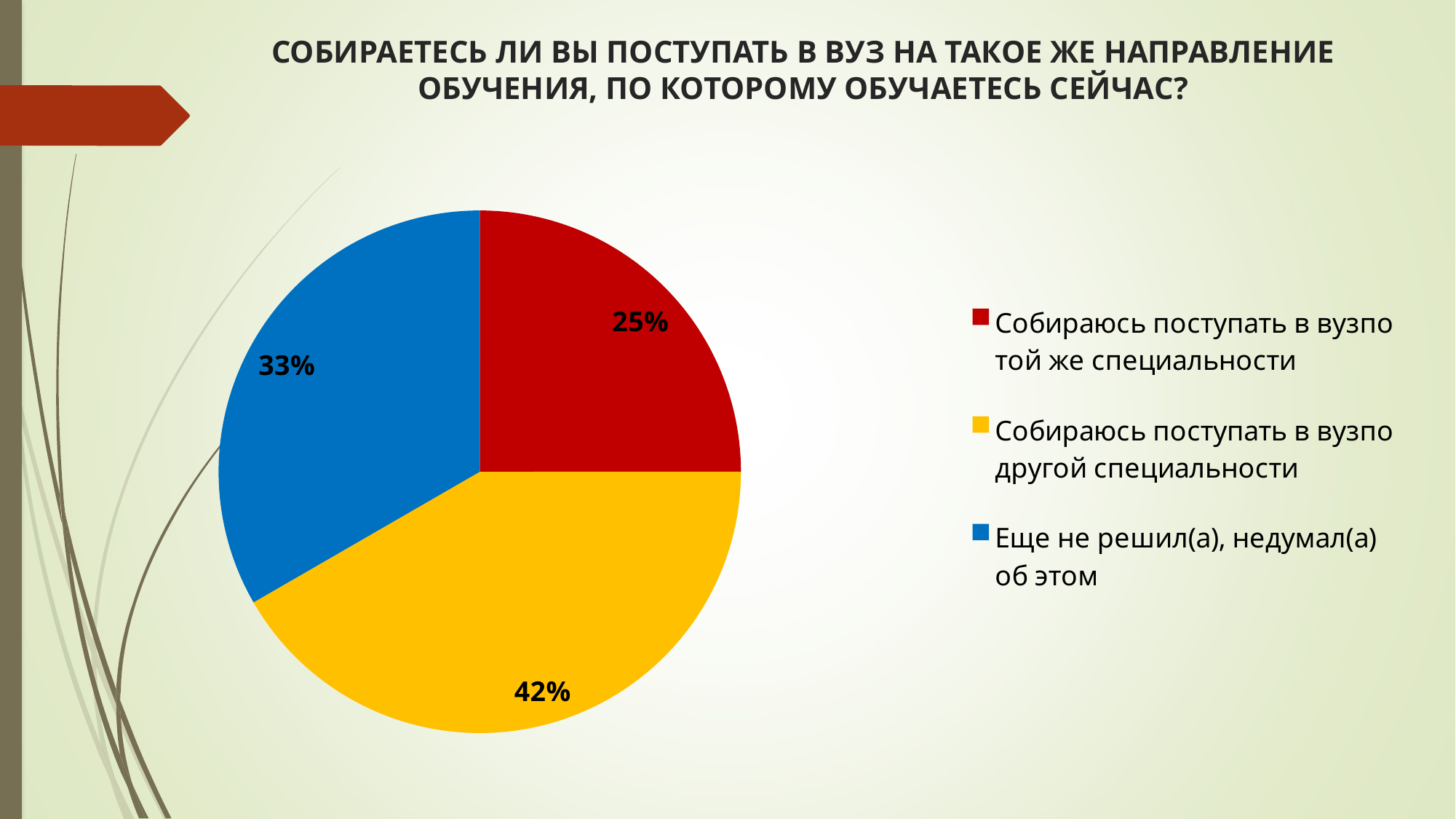
Which answer option has the largest share of the pie? Собираюсь поступать в вуз по другой специальности What share of respondents answered "Собираюсь поступать в вуз по той же специальности"? 25% What share of respondents answered "Собираюсь поступать в вуз по другой специальности"? 42% Which is larger: the share for "Еще не решил(а), не думал(а) об этом" or the share for "Собираюсь поступать в вуз по той же специальности"? Еще не решил(а), не думал(а) об этом What kind of chart is shown on the slide? pie chart What colour is the slice for "Собираюсь поступать в вуз по другой специальности"? yellow What share of respondents answered "Еще не решил(а), не думал(а) об этом"? 33% What is the difference in percentage points between the "другой специальности" slice and the "той же специальности" slice? 17 How many entries does the legend list? 3 What colour is the slice for "Еще не решил(а), не думал(а) об этом"? blue Which answer option has the smallest share of the pie? Собираюсь поступать в вуз по той же специальности How many slices does the pie chart have? 3